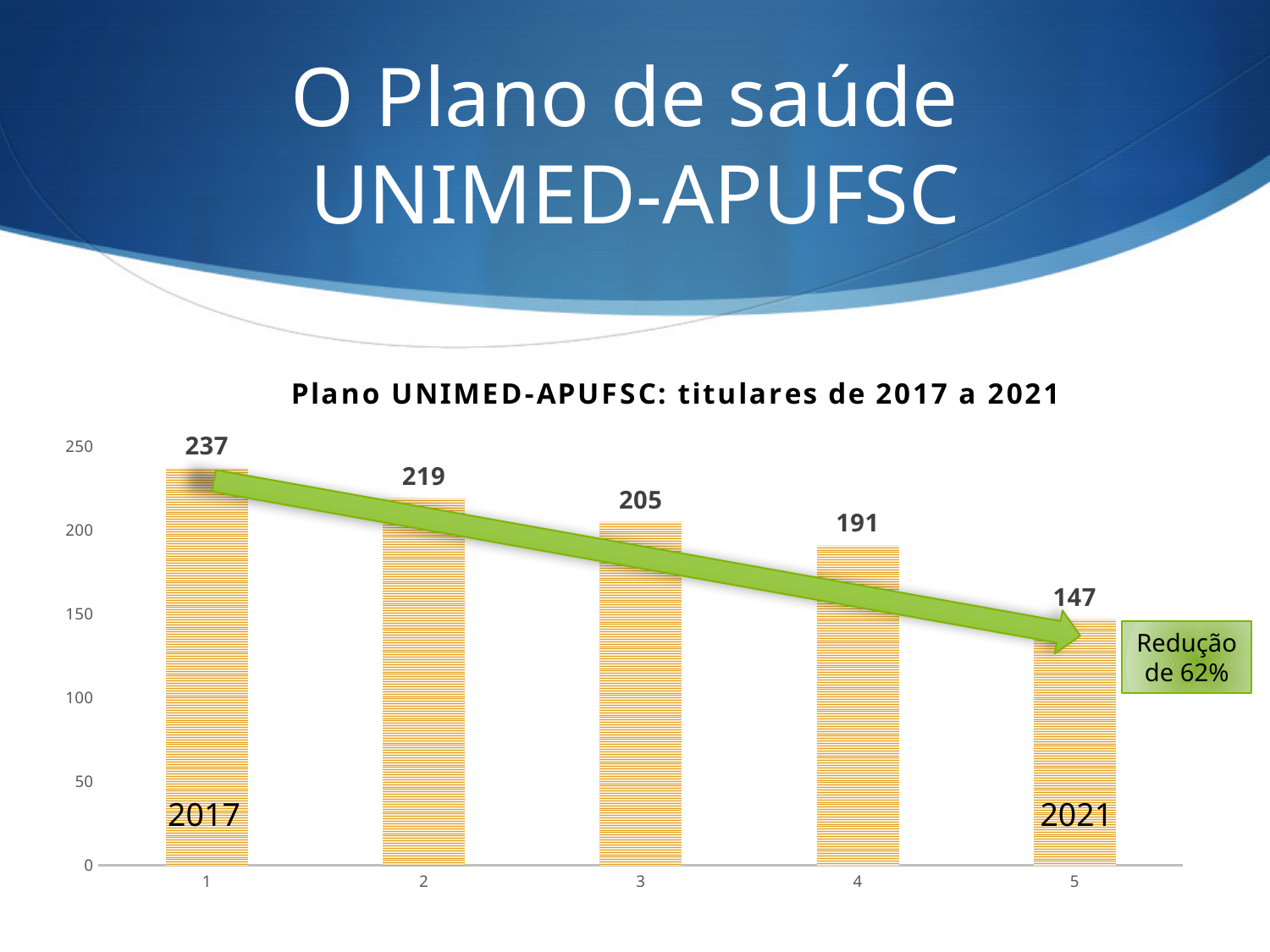
What is the difference between the values for category 1 and category 5? 90 Which category has the lowest value? 5 (2021) What kind of chart is shown on the slide? Bar chart What is the value of the bar for category 3? 205 What is the difference between the values for category 2 and category 4? 28 How many bars are plotted in the chart? 5 Which is larger, the value for category 2 or the value for category 4? Category 2 What is the value of the first bar (category 1, labelled 2017)? 237 Is the value for category 4 greater or less than 200? less What is the value of the last bar (category 5, labelled 2021)? 147 Do the values rise or fall from category 1 to category 5? Fall Which category has the highest value? 1 (2017)